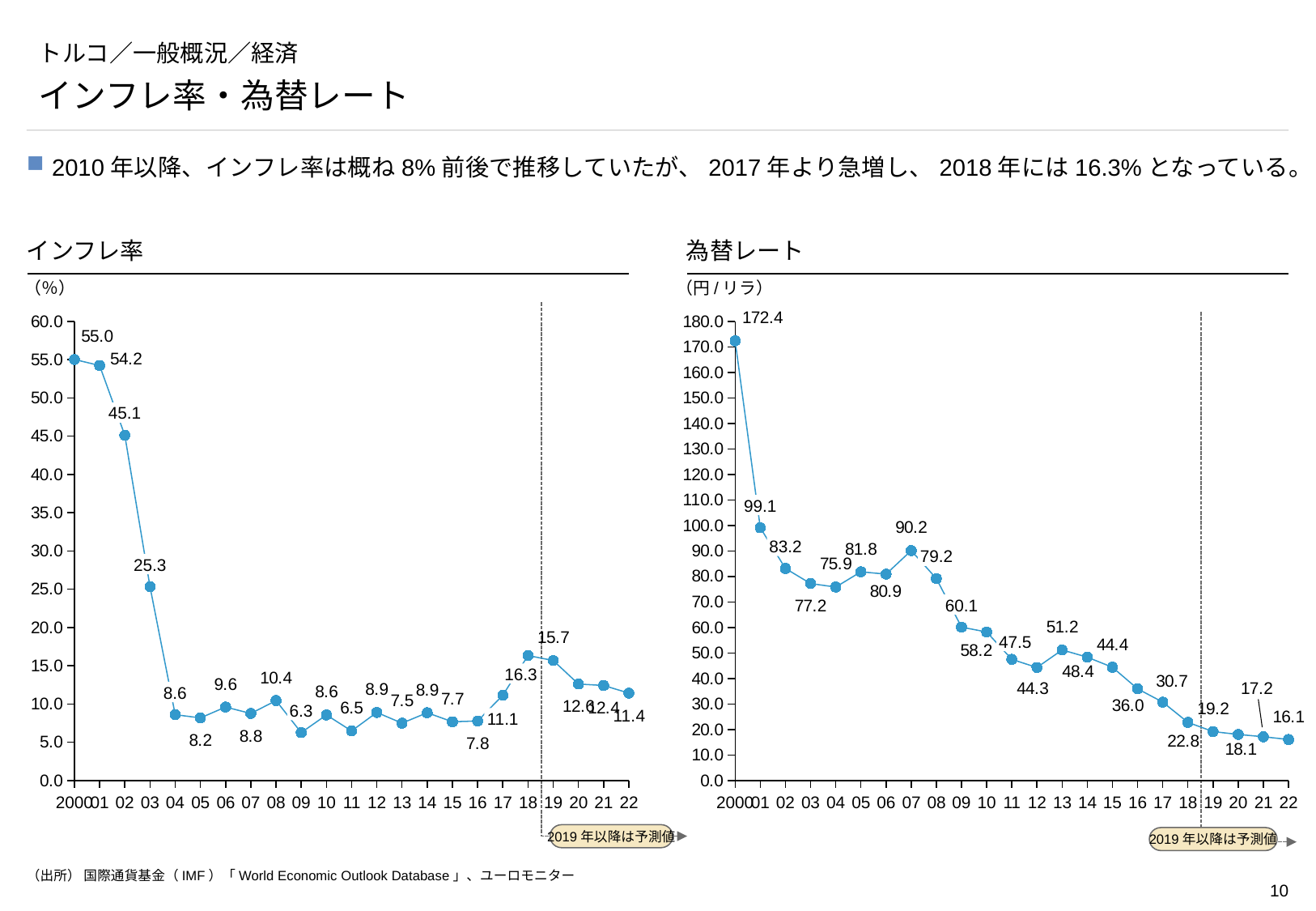
In the 為替レート chart, what is the difference between the 2000 value and the 2001 value? 73.3 In the 為替レート chart, do the values generally rise or fall from 2000 to 2022? fall In the インフレ率 chart, what is the inflation rate value for 2018? 16.3 In the 為替レート chart, what is the value for 2022? 16.1 In the インフレ率 chart, which is larger, the value for 2003 or the value for 2004? 2003 In the 為替レート chart, which year has the lowest value? 2022 In the インフレ率 chart, which year has the highest value? 2000 In the 為替レート chart, what is the value for 2000? 172.4 In the インフレ率 chart, what is the difference between the 2018 value and the 2017 value? 5.2 What kind of chart is the インフレ率 chart? line chart How many data points are plotted in the 為替レート chart? 23 In the インフレ率 chart, which year has the lowest value? 2009